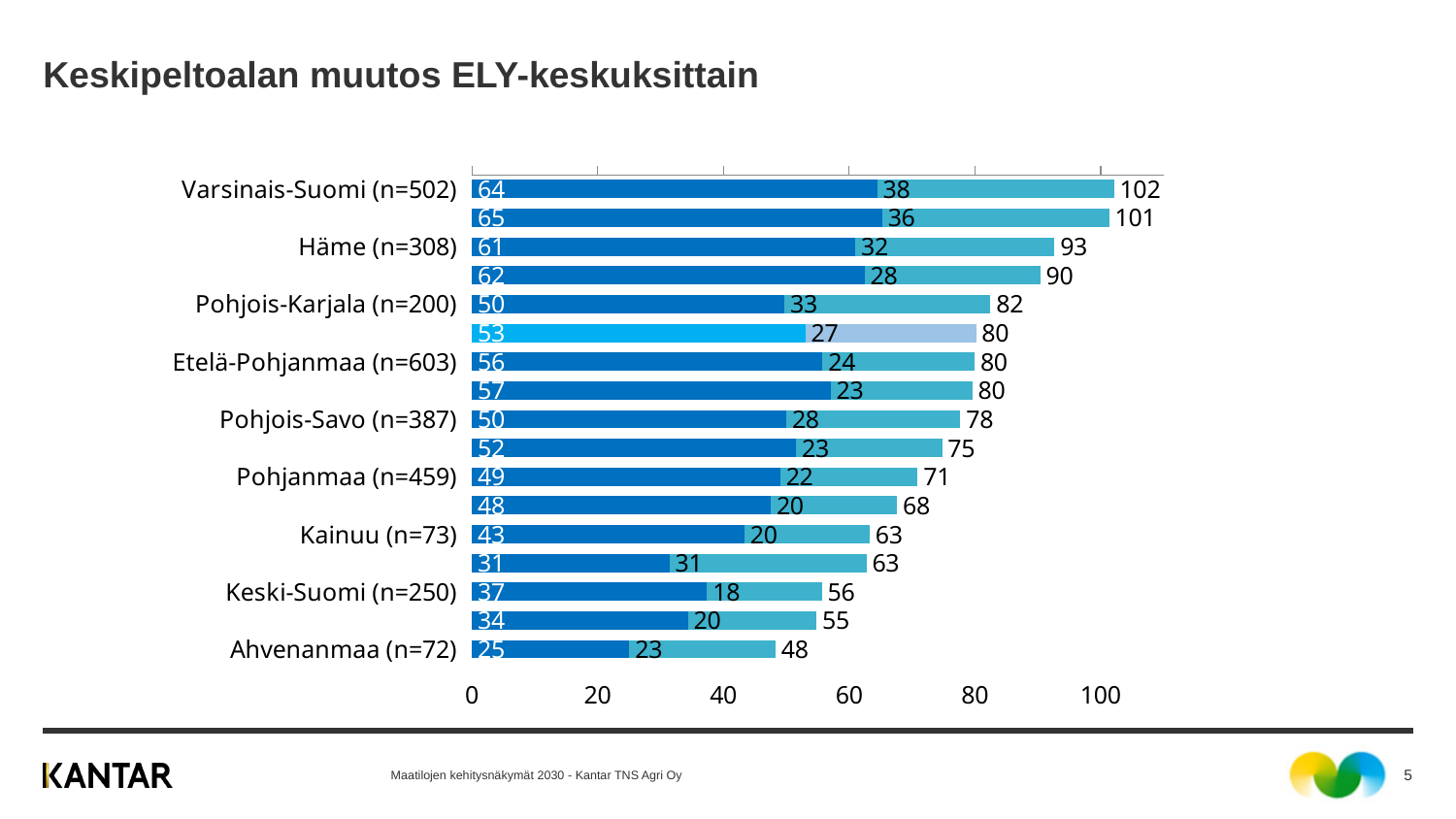
What is the value of the dark blue segment for Ahvenanmaa (n=72)? 25 What is the value of the dark blue segment for Häme (n=308)? 61 What is the total of the stacked bar for Keski-Suomi (n=250)? 56 What is the total value shown at the end of the bar for Varsinais-Suomi (n=502)? 102 Is the total value for Kainuu (n=73) greater or less than 80? less Which has the larger total, Etelä-Pohjanmaa (n=603) or Pohjanmaa (n=459)? Etelä-Pohjanmaa (n=603) Which labelled category has the lowest total value? Ahvenanmaa (n=72) What kind of chart is shown on the slide? bar chart What is the value of the light blue segment for Pohjois-Karjala (n=200)? 33 Which labelled category has the highest total value? Varsinais-Suomi (n=502) What is the title of the chart on the slide? Keskipeltoalan muutos ELY-keskuksittain What is the difference between the total for Häme (n=308) and the total for Pohjois-Savo (n=387)? 15